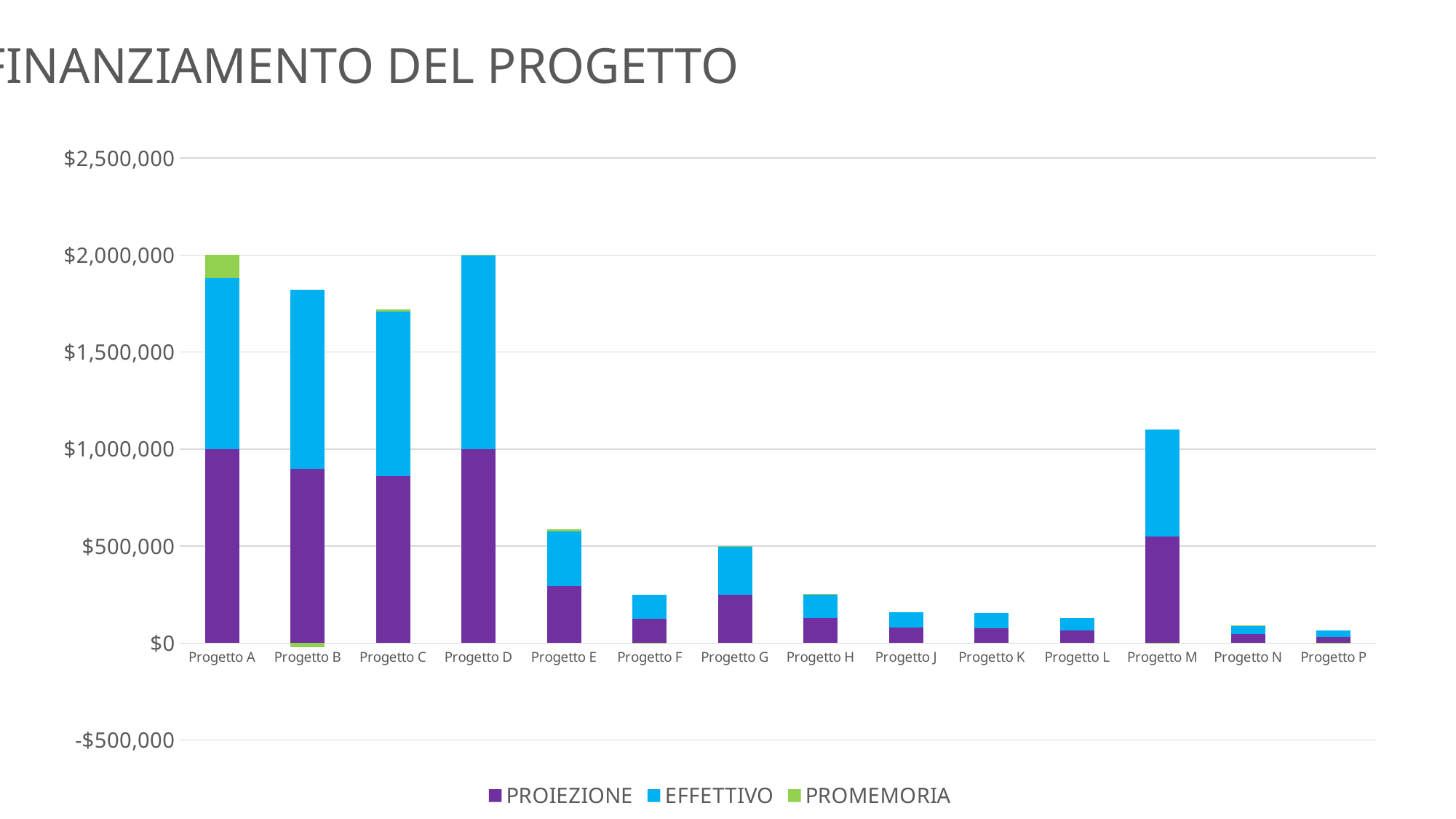
Which has the larger total stacked value, Progetto M or Progetto E? Progetto M What kind of chart is shown on the slide? Bar chart Is the PROIEZIONE value for Progetto B greater or less than $1,000,000? less How many projects (categories) are shown on the x axis? 14 What is the title of the chart? FINANZIAMENTO DEL PROGETTO Which series is shown in green in the legend? PROMEMORIA Is the total stacked value for Progetto M greater or less than $1,000,000? greater Is the total stacked value for Progetto E greater or less than $1,000,000? less How many series does the legend list? 3 Which project has the lowest total stacked value? Progetto P